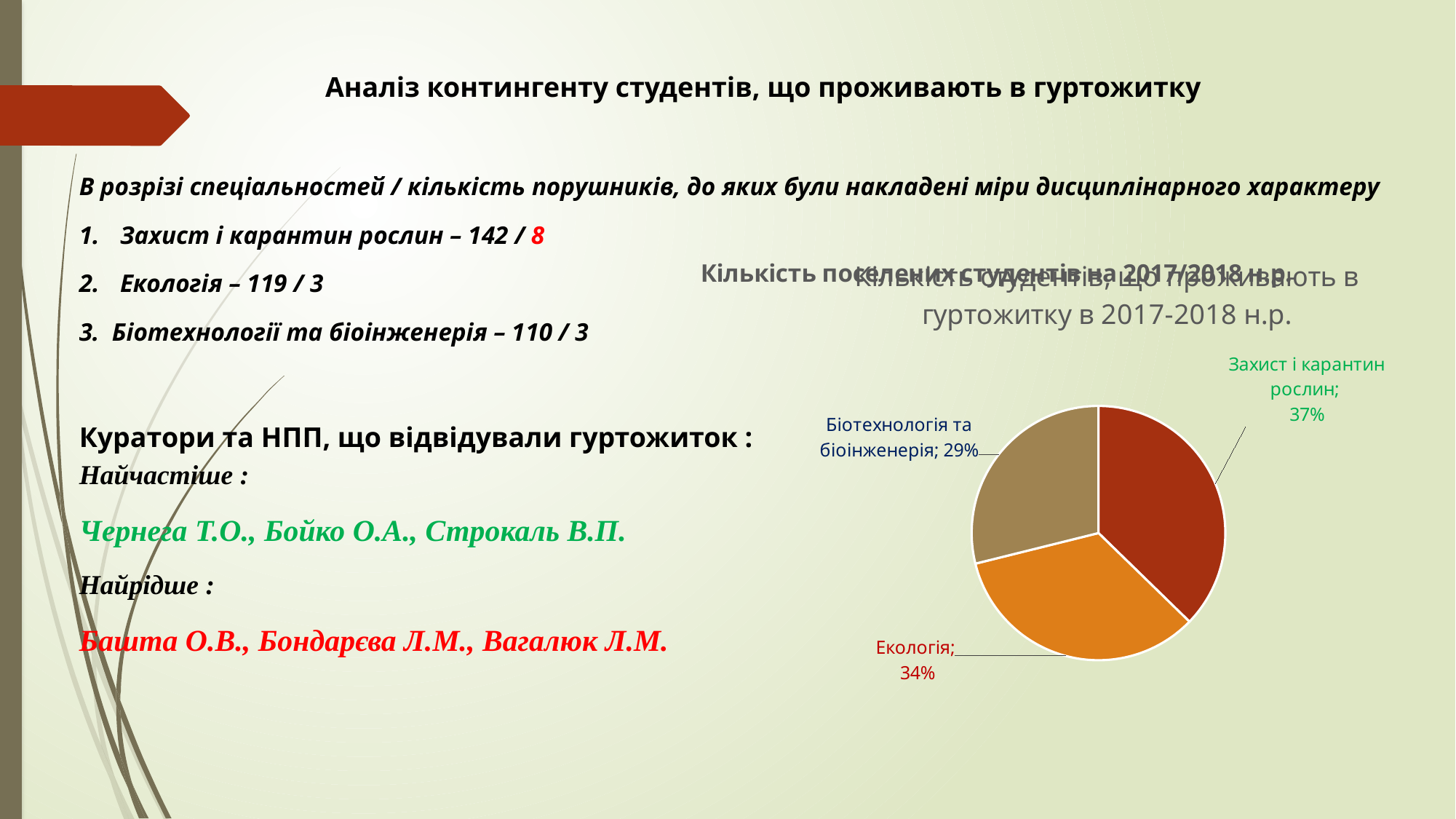
Which category has the smallest slice in the pie chart? Біотехнології та біоінженерія What colour is the slice for Екологія in the pie chart? orange By how many percentage points does Екологія exceed Біотехнології та біоінженерія in the pie chart? 5 What percentage is shown for Біотехнології та біоінженерія in the pie chart? 29% What is the value shown for Екологія in the pie chart? 34% What share of the pie chart does Захист і карантин рослин represent? 37% Which category has the largest slice in the pie chart? Захист і карантин рослин How many slices does the pie chart have? 3 By how many percentage points does Захист і карантин рослин exceed Екологія in the pie chart? 3 What colour is the slice for Захист і карантин рослин in the pie chart? dark red Which is larger in the pie chart: Екологія or Біотехнології та біоінженерія? Екологія What type of chart is shown on the slide? pie chart